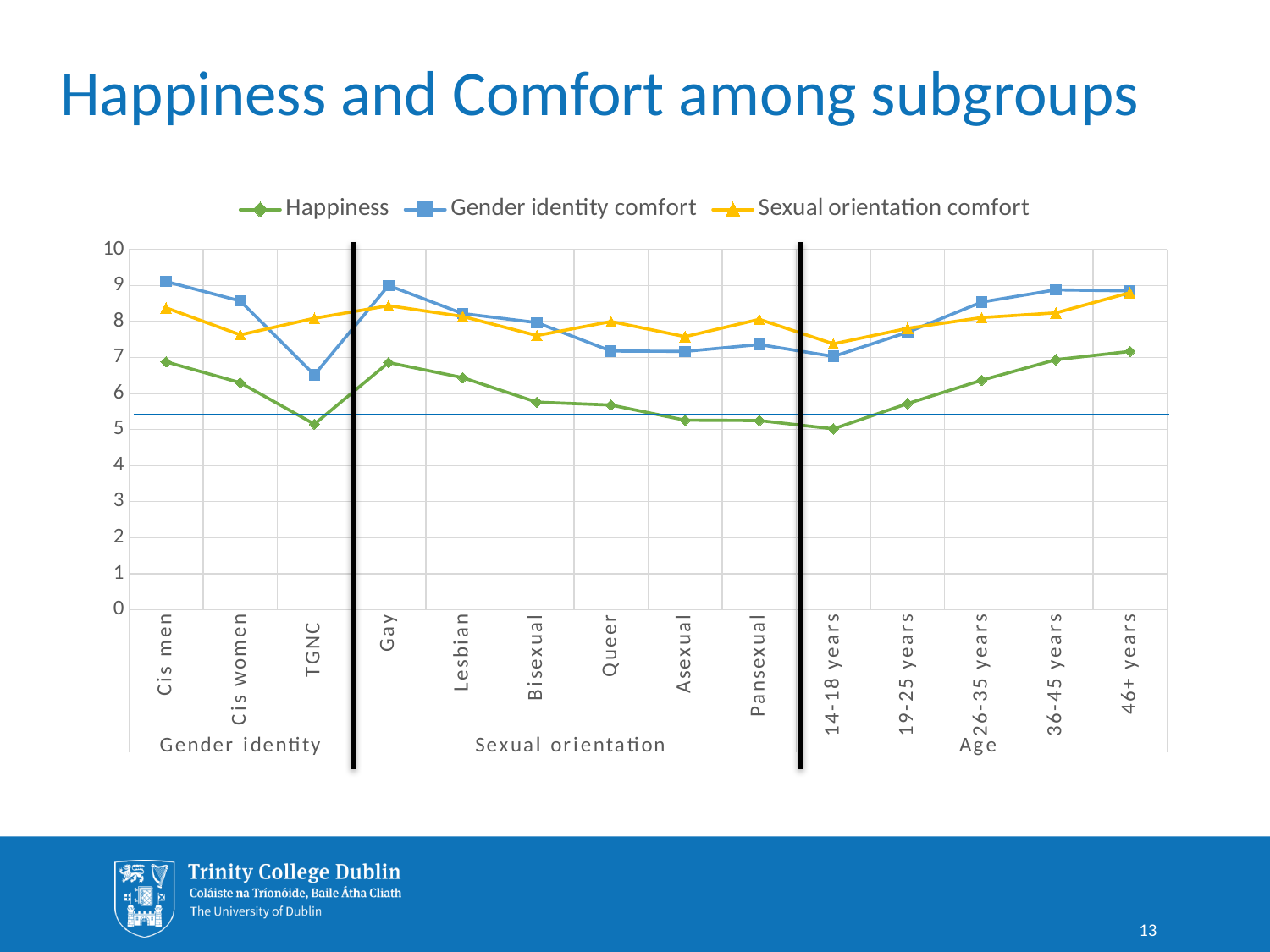
Is the Sexual orientation comfort value for Pansexual greater or less than 7? greater Is the Happiness value for TGNC greater or less than 6? less How many subgroup categories are plotted along the x axis? 14 What are the three group labels shown beneath the x axis categories? Gender identity, Sexual orientation, Age What kind of chart is shown on the slide? Line chart Does the Happiness series rise or fall across the age groups from 14-18 years to 46+ years? Rise Which has the higher Happiness value, Cis men or Cis women? Cis men Which subgroup has the highest Sexual orientation comfort value? 46+ years How many series does the legend list? 3 Which subgroup has the lowest Gender identity comfort value? TGNC Is the Gender identity comfort value for Cis men greater or less than 8? greater Which subgroup has the highest Happiness value? 46+ years